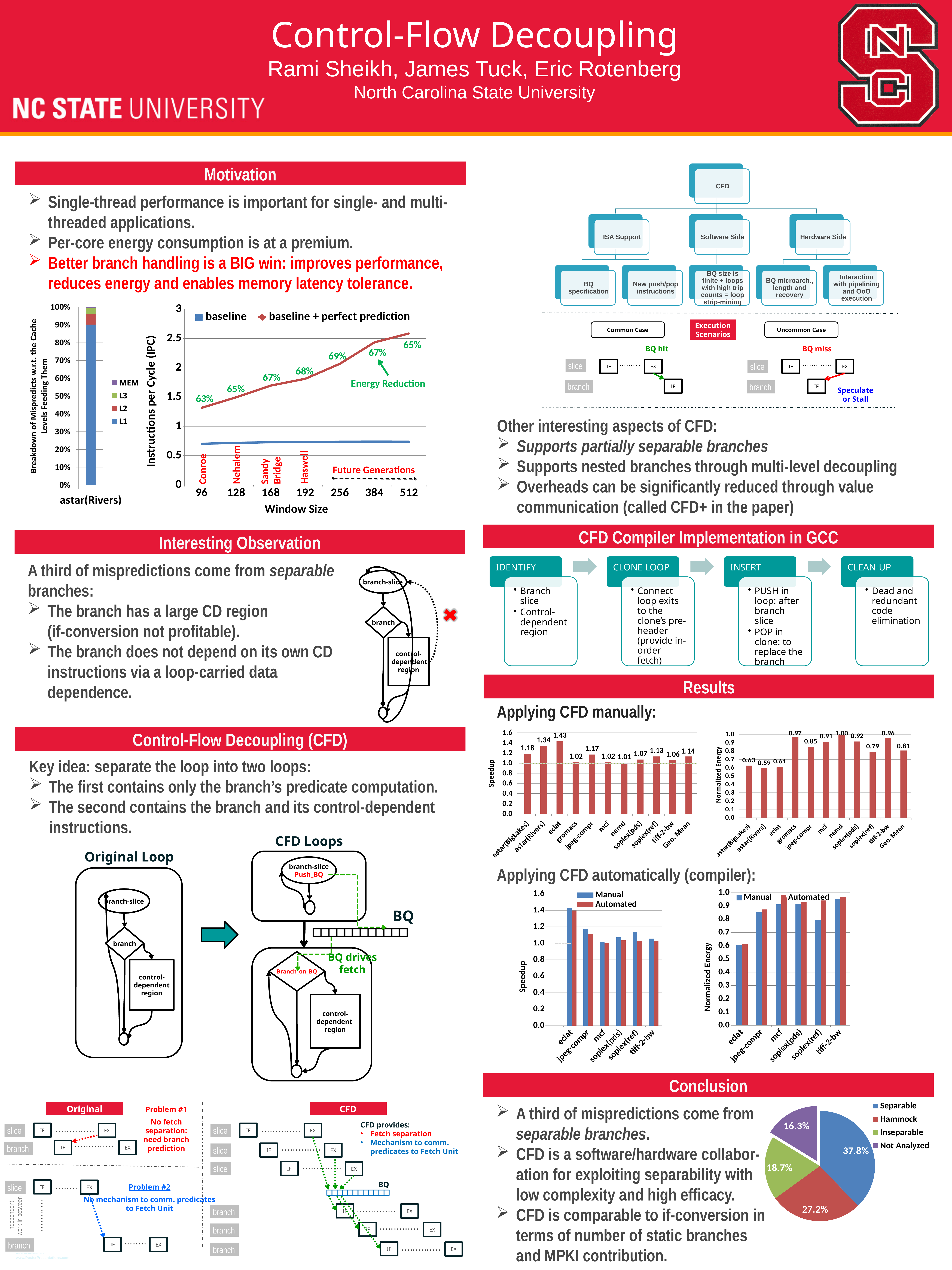
In the 'Applying CFD manually' Normalized Energy bar chart, what is the value for astar(Rivers)? 0.59 In the pie chart in the Conclusion section, what share of the pie is Separable? 37.8% In the 'Applying CFD manually' Speedup bar chart, what is the Geo. Mean speedup? 1.14 In the 'Applying CFD manually' Speedup bar chart, what is the speedup for eclat? 1.43 In the IPC vs Window Size line chart in the Motivation section, does the 'baseline + perfect prediction' line rise or fall as window size increases? rise In the 'Applying CFD automatically (compiler)' Speedup chart, is the Manual speedup for eclat greater or less than 1.2? greater In the pie chart in the Conclusion section, which category has the smallest slice? Not Analyzed In the 'Applying CFD manually' Speedup bar chart, which is larger, the speedup for astar(Rivers) or for jpeg-compr? astar(Rivers) In the IPC vs Window Size line chart in the Motivation section, how many series does the legend list? 2 In the 'Applying CFD manually' Speedup bar chart, which benchmark has the highest speedup? eclat In the 'Applying CFD manually' Normalized Energy bar chart, what is the difference between the values for namd and astar(Rivers)? 0.41 How many slices does the pie chart in the Conclusion section have? 4